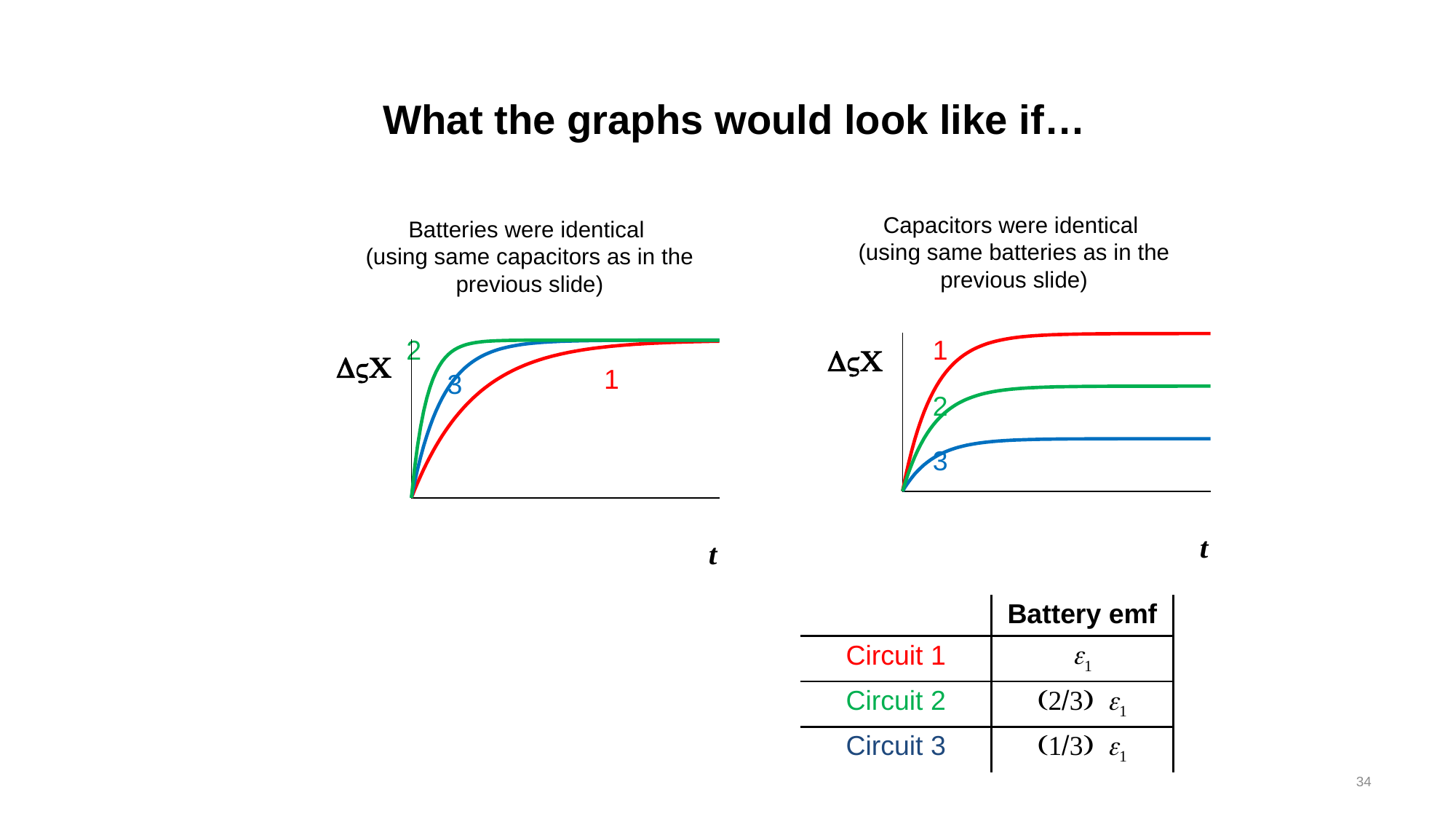
What is the label on the horizontal axis of the right chart ("Capacitors were identical")? t How many curves are plotted on the left chart ("Batteries were identical")? 3 On the right chart ("Capacitors were identical"), which curve levels off at the highest value? 1 On the left chart ("Batteries were identical"), do the curves rise or fall as t increases? rise On the right chart ("Capacitors were identical"), which curve reaches a higher final value, curve 2 or curve 3? curve 2 On the right chart ("Capacitors were identical"), what colour is curve 1? red How many curves are plotted on the right chart ("Capacitors were identical")? 3 What kind of chart is the left chart titled "Batteries were identical"? line chart On the right chart ("Capacitors were identical"), which curve levels off at the lowest value? 3 On the left chart ("Batteries were identical"), which curve rises to its plateau slowest? 1 On the left chart ("Batteries were identical"), which curve rises to its plateau fastest? 2 What kind of chart is the right chart titled "Capacitors were identical"? line chart